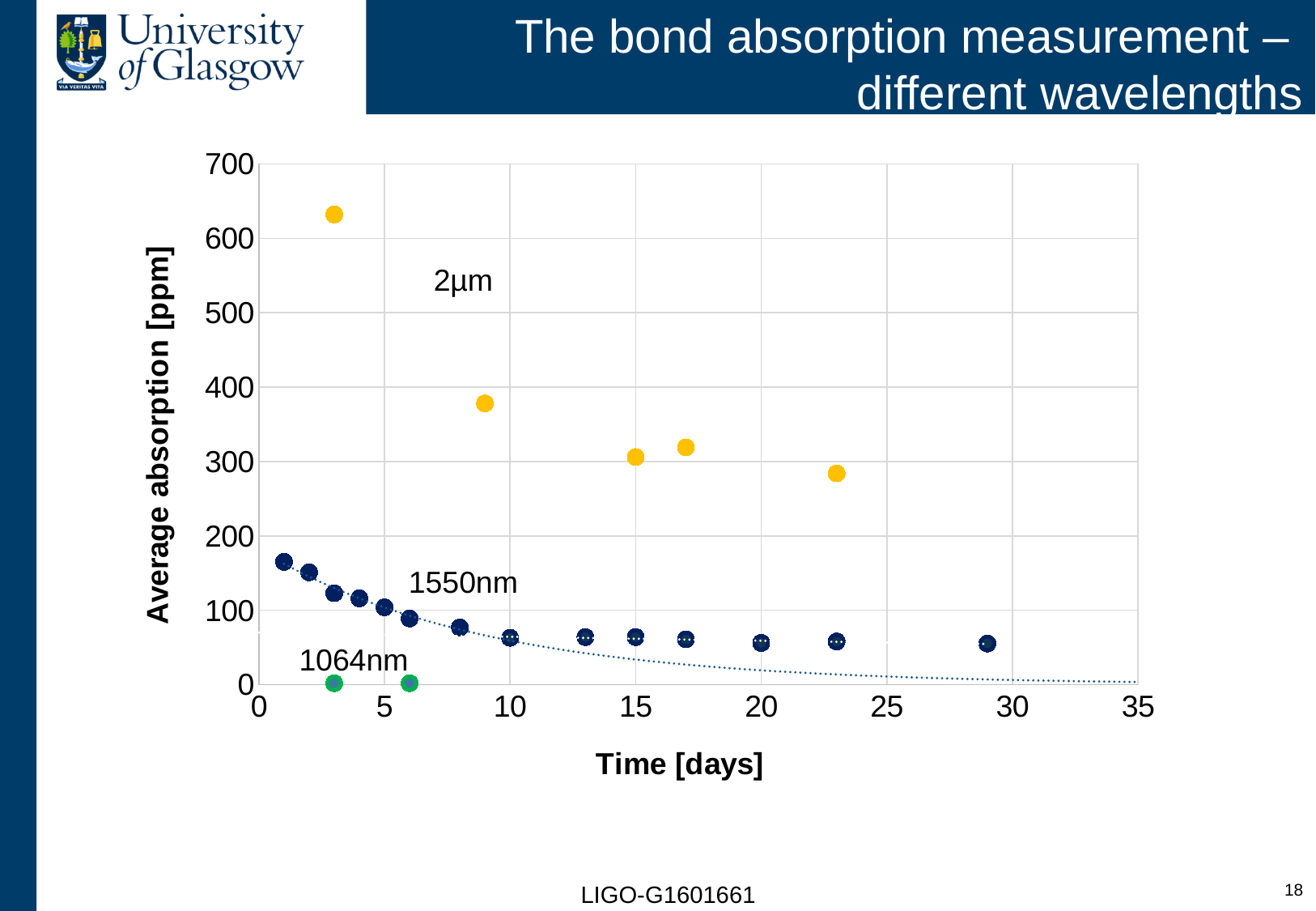
Which wavelength series has the highest average absorption values? 2µm Which wavelength series has the lowest average absorption values? 1064nm At around 15 days, which series has the larger average absorption, 2µm or 1550nm? 2µm What is the title of the vertical axis? Average absorption [ppm] How many data points are plotted for the 1064nm series? 2 Is the 1550nm data point at day 1 greater or less than 100 ppm? greater How many data points are plotted for the 2µm series? 5 Is the first 2µm data point (around day 3) greater or less than 600 ppm? greater What kind of chart is shown on the slide? Scatter chart How many wavelength series are plotted on the chart? 3 Do the 2µm absorption values rise or fall as time increases? fall Is the 1550nm data point at day 29 greater or less than 100 ppm? less